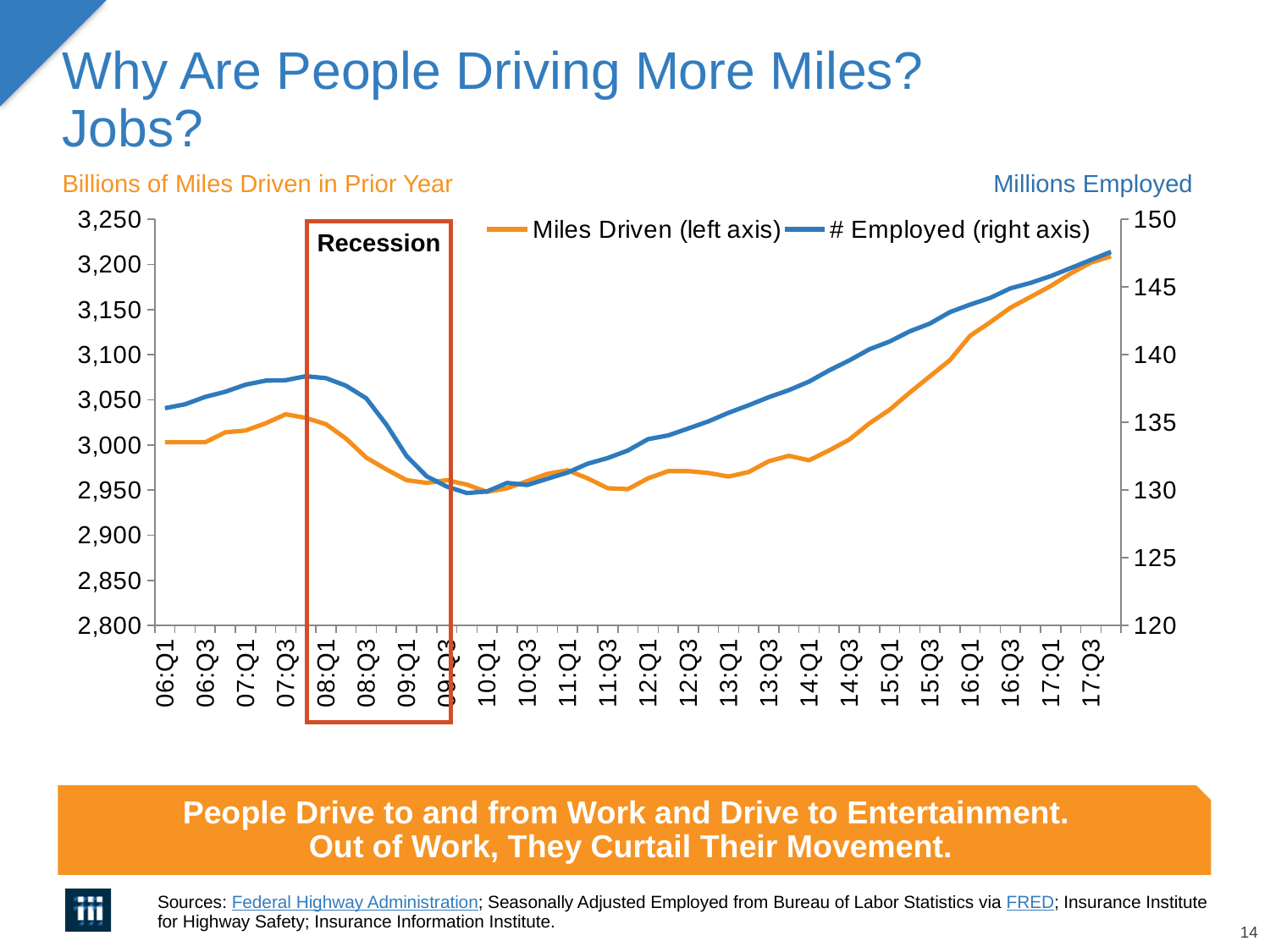
What label is shown on the boxed region of the chart? Recession How many series does the chart legend list? 2 What kind of chart is shown on the slide? line chart Does the Miles Driven series rise or fall between 10:Q1 and 17:Q3? rise Is the Miles Driven value at 10:Q1 greater or less than 3,000? less Is the Miles Driven value at 07:Q3 greater or less than 3,000? greater Is the # Employed value at 17:Q3 greater or less than 145? greater At which quarter does the Miles Driven series reach its highest value? 17:Q4 Does the # Employed series rise or fall between 08:Q1 and 09:Q3? fall Which series is plotted against the right axis? # Employed